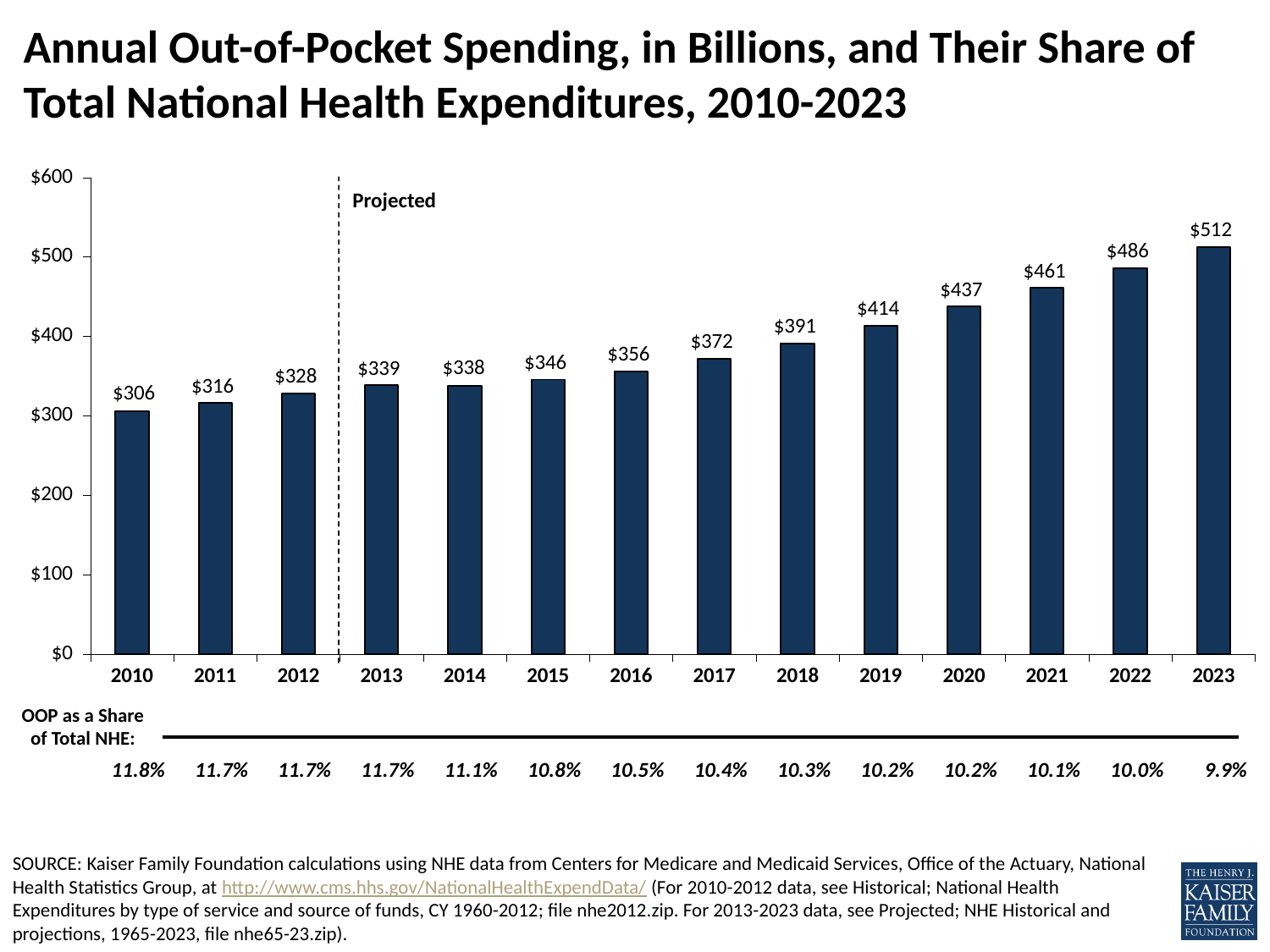
Which year has the lowest out-of-pocket spending? 2010 Do the OOP share of total NHE values generally rise or fall from 2010 to 2023? Fall What is the out-of-pocket spending value shown for 2018? $391 What is the OOP share of total NHE shown for 2023? 9.9% What label appears next to the dashed vertical line between 2012 and 2013? Projected What is the out-of-pocket spending value shown for 2010? $306 What is the difference between the out-of-pocket spending in 2023 and in 2010? $206 Which is larger, the out-of-pocket spending in 2013 or in 2014? 2013 Which year has the highest out-of-pocket spending? 2023 What kind of chart is shown on the slide? Bar chart How many years are shown on the x axis? 14 Is the value for 2020 greater or less than $400? greater